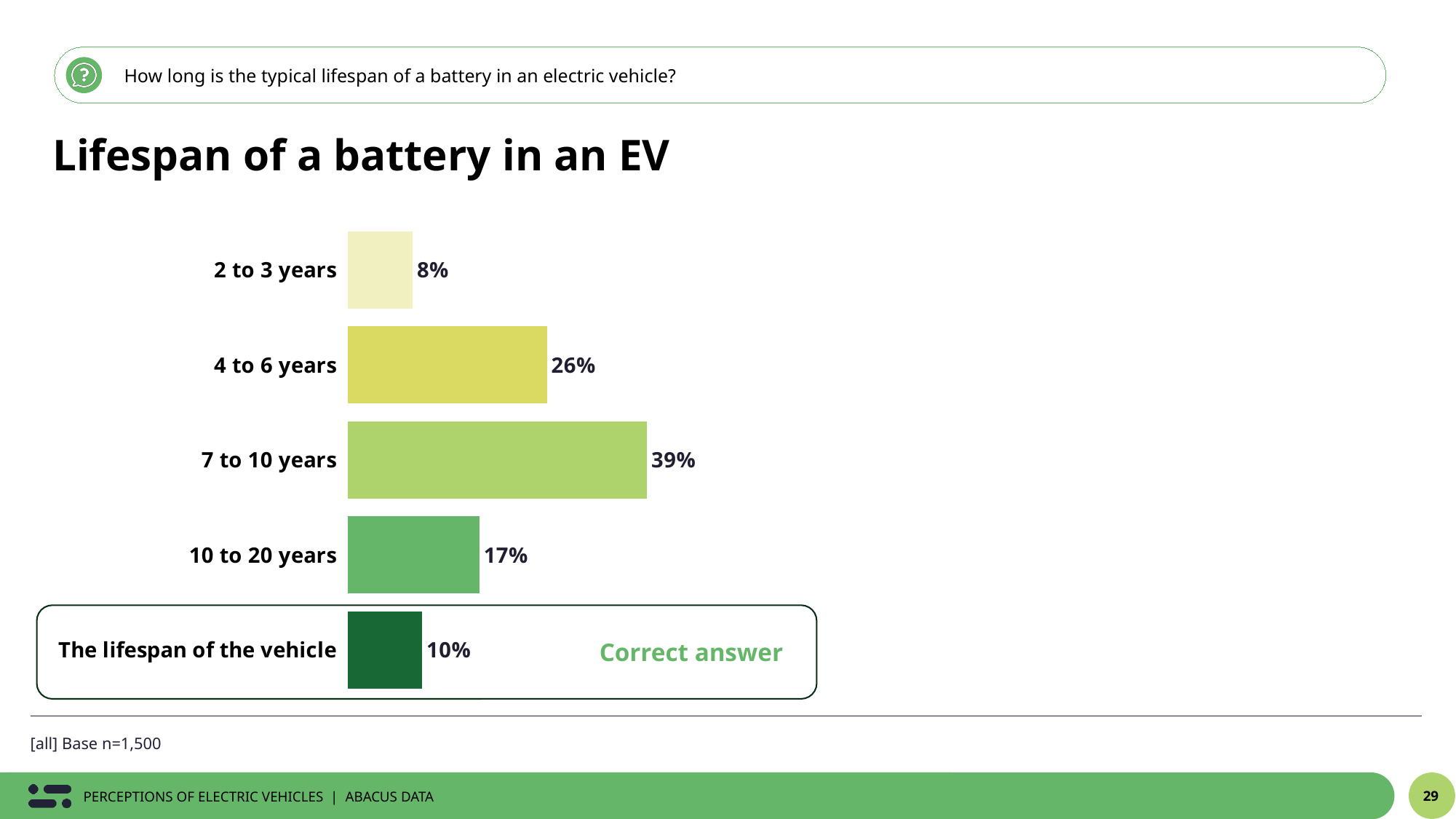
What type of chart is shown on the slide? Bar chart How many response categories are shown in the chart? 5 What percentage of respondents chose '2 to 3 years'? 8% What is the title of the chart? Lifespan of a battery in an EV Which response category is marked as the correct answer? The lifespan of the vehicle Which response category has the lowest percentage? 2 to 3 years What percentage of respondents chose 'The lifespan of the vehicle'? 10% What percentage of respondents chose '10 to 20 years'? 17% What percentage of respondents said the typical lifespan of an EV battery is 7 to 10 years? 39% Which has a larger share of respondents: '4 to 6 years' or '10 to 20 years'? 4 to 6 years Which response category has the highest percentage? 7 to 10 years What is the difference in percentage points between '7 to 10 years' and '4 to 6 years'? 13